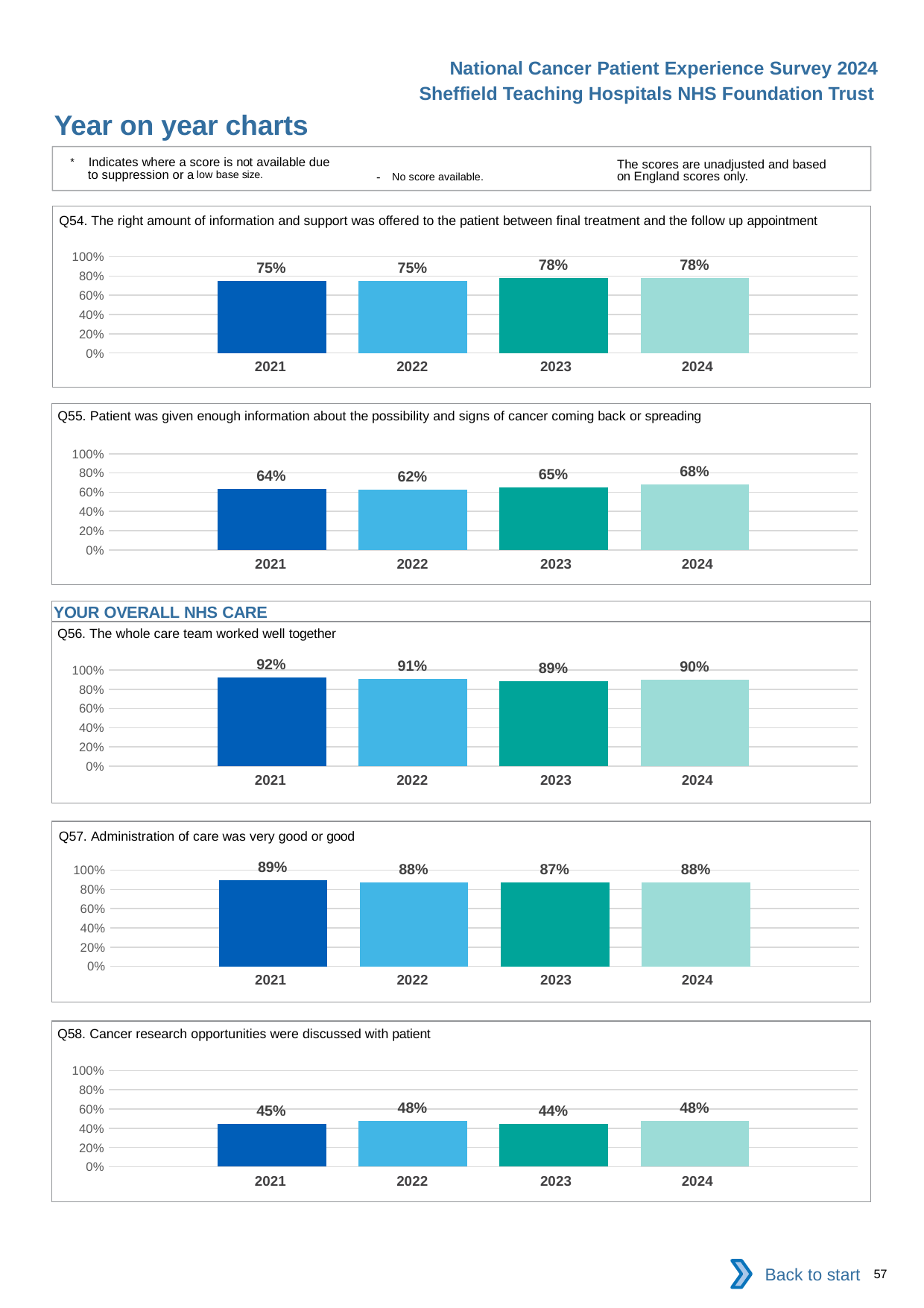
In the Q57 chart, which is larger, the value for 2021 or the value for 2023? 2021 How many years are shown on the x axis of the Q58 chart? 4 In the Q55 chart, which year has the lowest value? 2022 In the Q58 chart, what is the difference between the 2022 value and the 2023 value? 4% In the Q58 chart, is the value for 2023 greater or less than 60%? less In the Q55 chart, what is the value for 2021? 64% In the Q55 chart, which year has the highest value? 2024 In the Q56 chart, what is the difference between the 2021 value and the 2023 value? 3% In the Q56 chart, which year has the lowest value? 2023 How many charts are shown on the slide? 5 In the Q54 chart, what is the value for 2023? 78% What kind of chart is the Q54 chart? bar chart